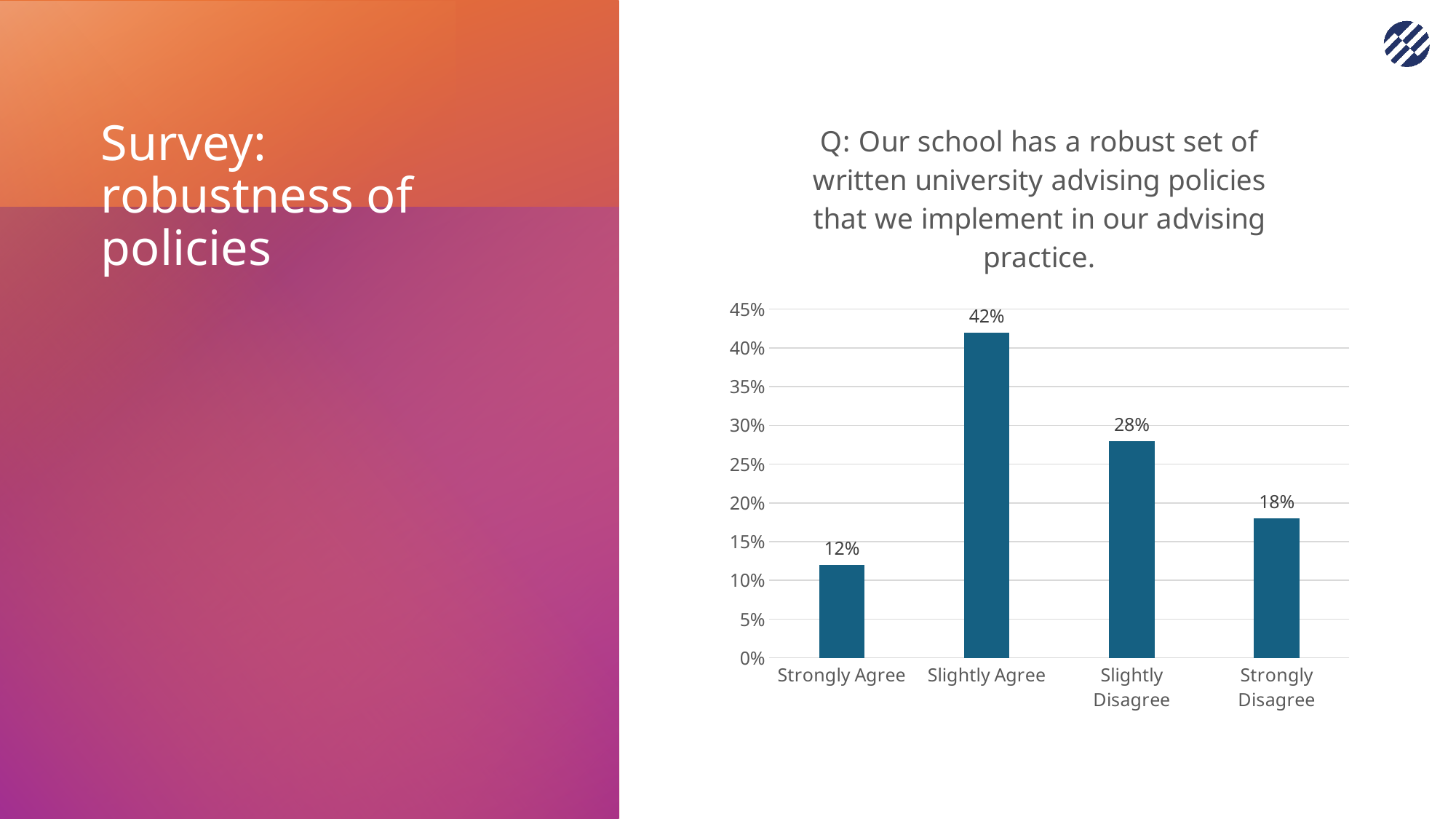
What percentage of respondents answered Strongly Agree? 12% Which is larger, the value for Strongly Disagree or the value for Strongly Agree? Strongly Disagree What percentage of respondents answered Slightly Agree? 42% What percentage of respondents answered Slightly Disagree? 28% What is the highest value shown on the vertical axis of the chart? 45% Which response category has the highest percentage? Slightly Agree Is the value for Slightly Disagree greater or less than 25%? greater Which response category has the lowest percentage? Strongly Agree What percentage of respondents answered Strongly Disagree? 18% What is the difference in percentage points between Slightly Agree and Slightly Disagree? 14 How many response categories are shown on the chart? 4 What kind of chart is shown on the slide? Bar chart